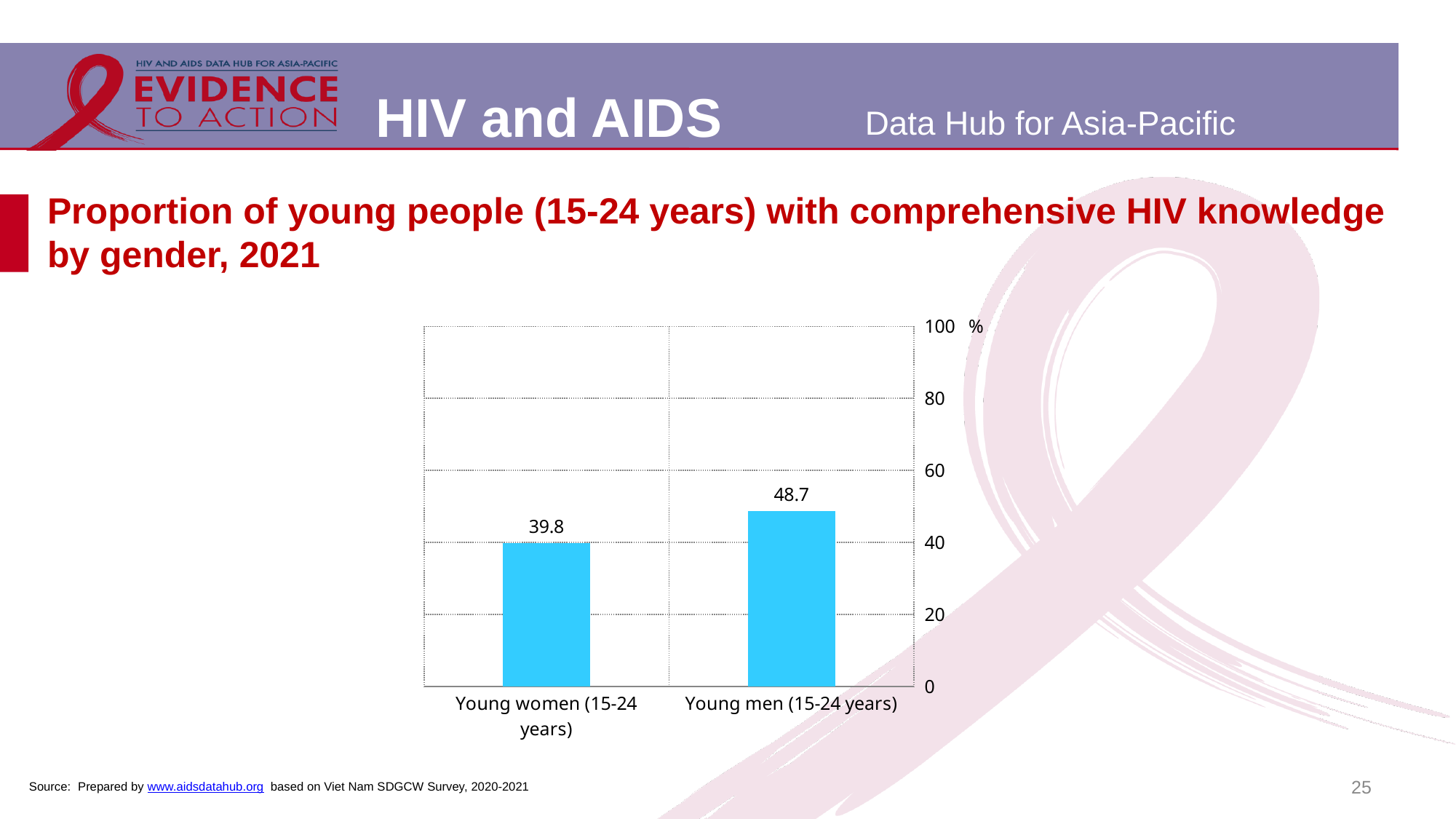
Which is larger, the value for Young women (15-24 years) or Young men (15-24 years)? Young men (15-24 years) Which category has the lowest value? Young women (15-24 years) Is the value for Young women (15-24 years) greater or less than 40? less Is the value for Young men (15-24 years) greater or less than 60? less Which category has the highest value? Young men (15-24 years) How many categories are shown on the chart? 2 What kind of chart is shown on the slide? Bar chart What is the value for Young women (15-24 years)? 39.8 What unit is shown at the top of the vertical axis? % What is the difference between the values for Young men (15-24 years) and Young women (15-24 years)? 8.9 What is the value for Young men (15-24 years)? 48.7 What is the maximum value shown on the vertical axis? 100